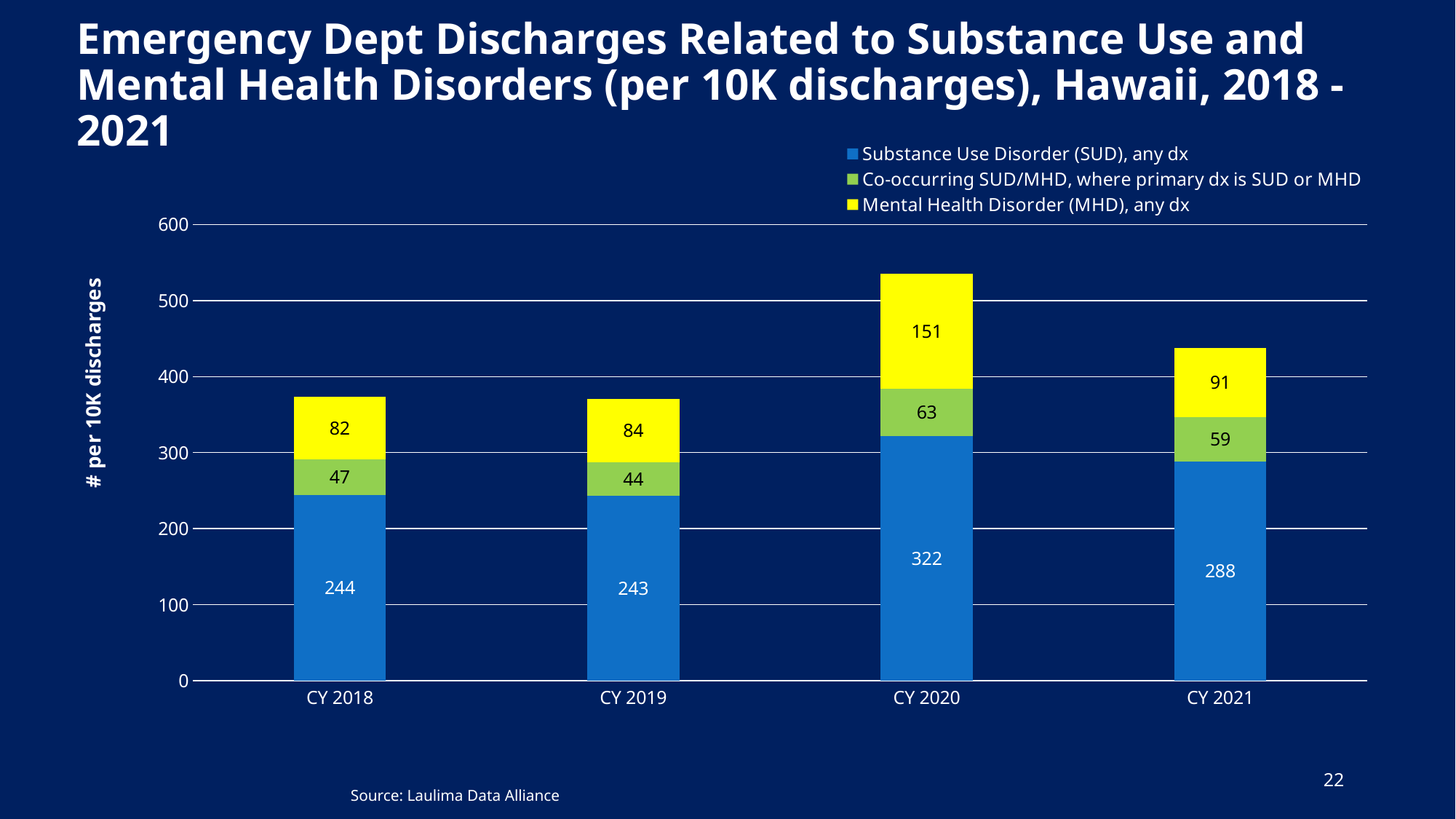
What is the value for Substance Use Disorder (SUD), any dx in CY 2020? 322 What is the difference between the Mental Health Disorder (MHD) values for CY 2020 and CY 2021? 60 What is the value for Co-occurring SUD/MHD in CY 2021? 59 What is the total of the stacked bar for CY 2020? 536 What is the total of the stacked bar for CY 2018? 373 How many series does the legend list? 3 Which year has the highest value for Mental Health Disorder (MHD), any dx? CY 2020 Which year has the lowest value for Co-occurring SUD/MHD? CY 2019 How many years are shown on the x axis? 4 What is the value for Mental Health Disorder (MHD), any dx in CY 2018? 82 What kind of chart is shown on the slide? Stacked bar chart Which is larger: the Substance Use Disorder (SUD) value for CY 2021 or for CY 2018? CY 2021